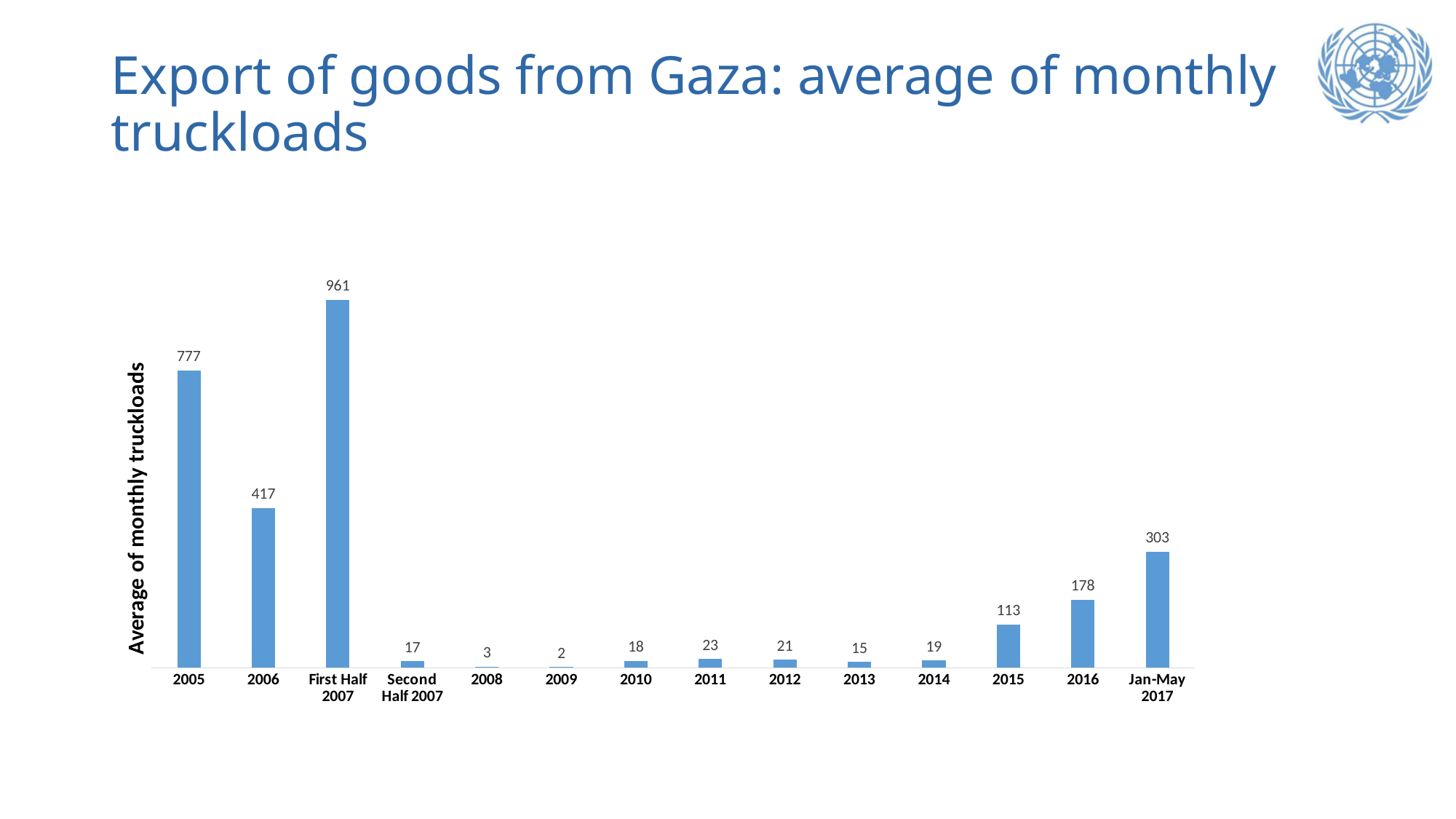
What is the average of monthly truckloads for 2005? 777 What kind of chart is shown on the slide? Bar chart What is the difference between the average monthly truckloads in 2005 and 2006? 360 What is the label of the vertical axis of the chart? Average of monthly truckloads How many categories are shown on the x axis of the chart? 14 What is the average of monthly truckloads for Jan-May 2017? 303 What is the average of monthly truckloads for the Second Half 2007? 17 Which is larger, the average monthly truckloads in 2011 or in 2013? 2011 Do the values rise or fall from 2014 to Jan-May 2017? Rise Which category has the lowest average of monthly truckloads? 2009 Which category has the highest average of monthly truckloads? First Half 2007 What is the difference between the average monthly truckloads in 2016 and 2015? 65